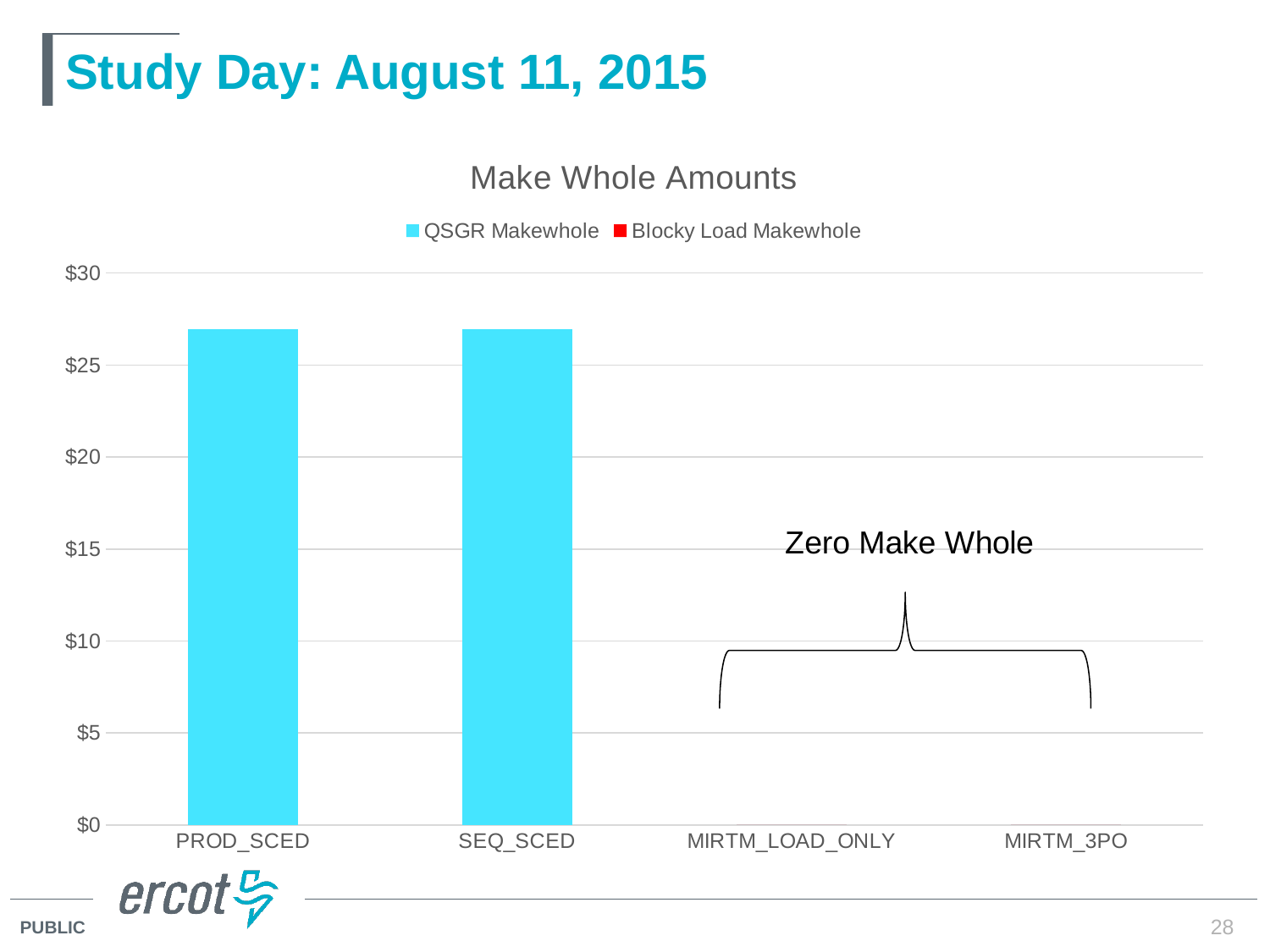
Is the QSGR Makewhole value for SEQ_SCED greater or less than $30? less How many categories are shown on the x axis of the chart? 4 Which is larger, the QSGR Makewhole value for SEQ_SCED or for MIRTM_LOAD_ONLY? SEQ_SCED Is the QSGR Makewhole value for PROD_SCED greater or less than $25? greater What does the annotation on the chart say about the MIRTM_LOAD_ONLY and MIRTM_3PO categories? Zero Make Whole Which is larger, the QSGR Makewhole value for PROD_SCED or for MIRTM_3PO? PROD_SCED What kind of chart is shown on the slide? bar chart What is the title of the chart? Make Whole Amounts Is the QSGR Makewhole value for SEQ_SCED greater or less than $20? greater How many series does the chart legend list? 2 Which series in the legend is shown in red? Blocky Load Makewhole